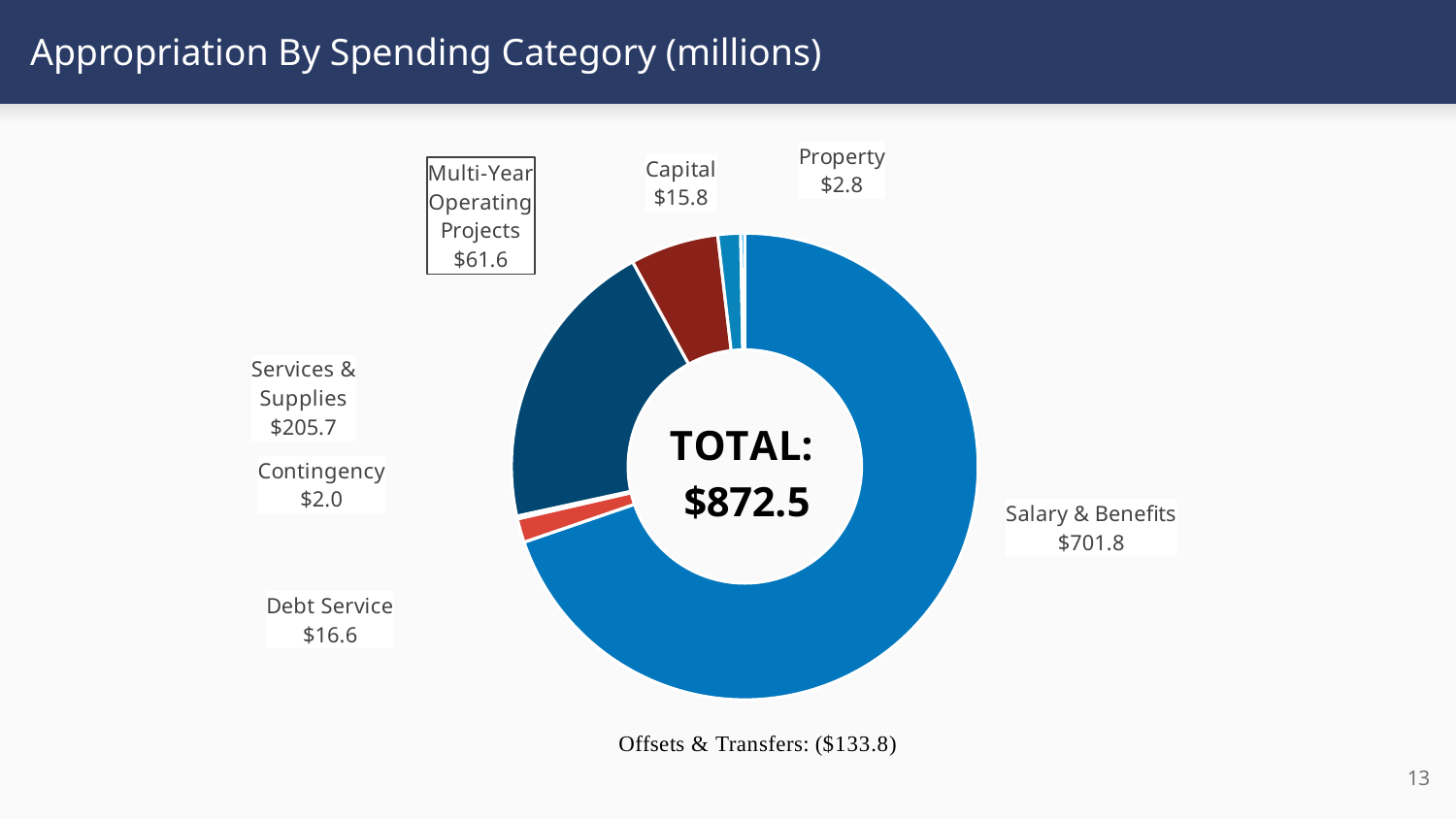
What is the difference between Salary & Benefits and Services & Supplies? $496.1 What is the value for Salary & Benefits? $701.8 How many spending categories are shown in the chart? 7 What total is shown in the center of the chart? $872.5 What is the value for Property? $2.8 What is the value for Services & Supplies? $205.7 What is the value for Multi-Year Operating Projects? $61.6 What is the value for Debt Service? $16.6 What type of chart is shown on the slide? doughnut chart Which is larger, Services & Supplies or Multi-Year Operating Projects? Services & Supplies Which spending category has the largest value? Salary & Benefits Which spending category has the smallest value? Contingency